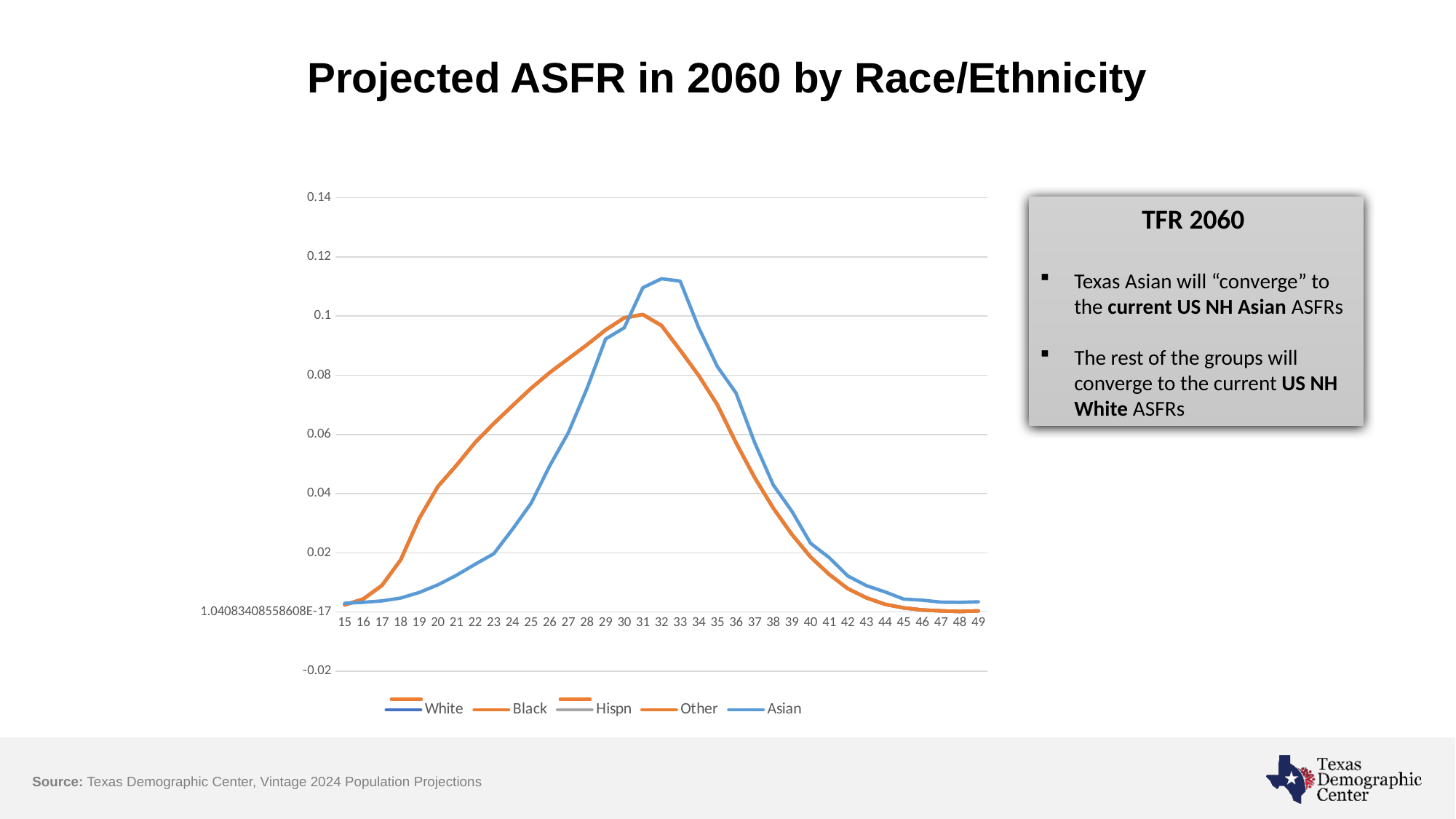
Is the value for Other at age 25 greater or less than 0.08? less At age 20, which series has the higher value, Asian or Other? Other What kind of chart is shown on the slide? line chart Does the Asian series rise or fall from age 33 to age 49? fall Is the value for Asian at age 29 greater or less than 0.08? greater What is the title of the chart? Projected ASFR in 2060 by Race/Ethnicity At age 33, which series has the higher value, Asian or Other? Asian How many series does the legend list? 5 Is the value for Asian at age 24 greater or less than 0.04? less How many age categories are shown along the x axis? 35 Which series reaches the highest peak value on the chart? Asian